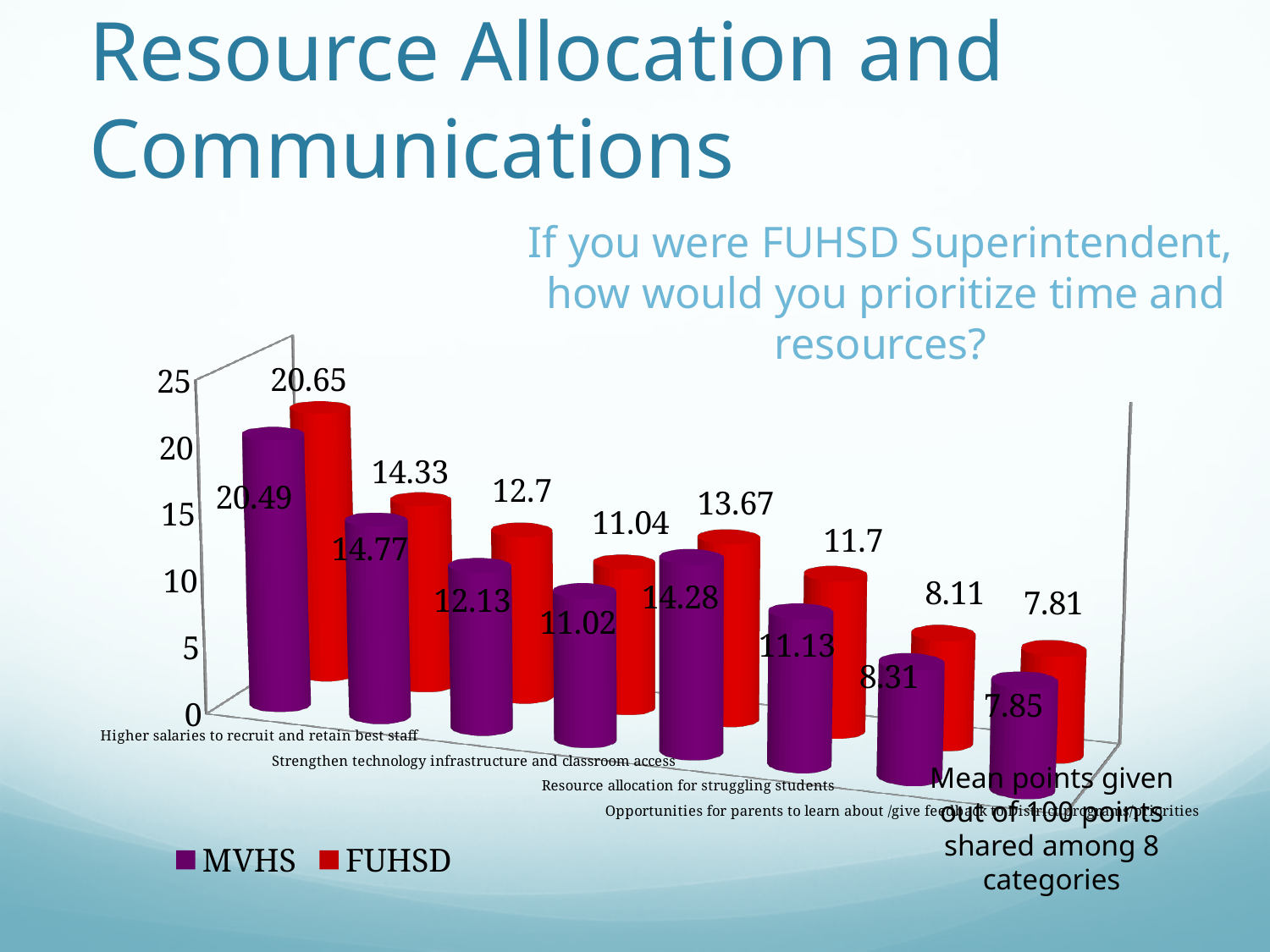
What is the lowest MVHS value shown in the chart? 7.85 What is the MVHS value for 'Higher salaries to recruit and retain best staff'? 20.49 What is the highest MVHS value shown in the chart? 20.49 How many series does the chart legend list? 2 What is the FUHSD value for 'Resource allocation for struggling students'? 13.67 What is the FUHSD value for 'Higher salaries to recruit and retain best staff'? 20.65 What is the lowest FUHSD value shown in the chart? 7.81 How many categories are plotted in the chart? 8 For 'Higher salaries to recruit and retain best staff', how much larger is the FUHSD value than the MVHS value? 0.16 What are the two series named in the chart legend? MVHS and FUHSD What kind of chart is shown on the slide? bar chart For 'Resource allocation for struggling students', which series has the larger value, MVHS or FUHSD? MVHS